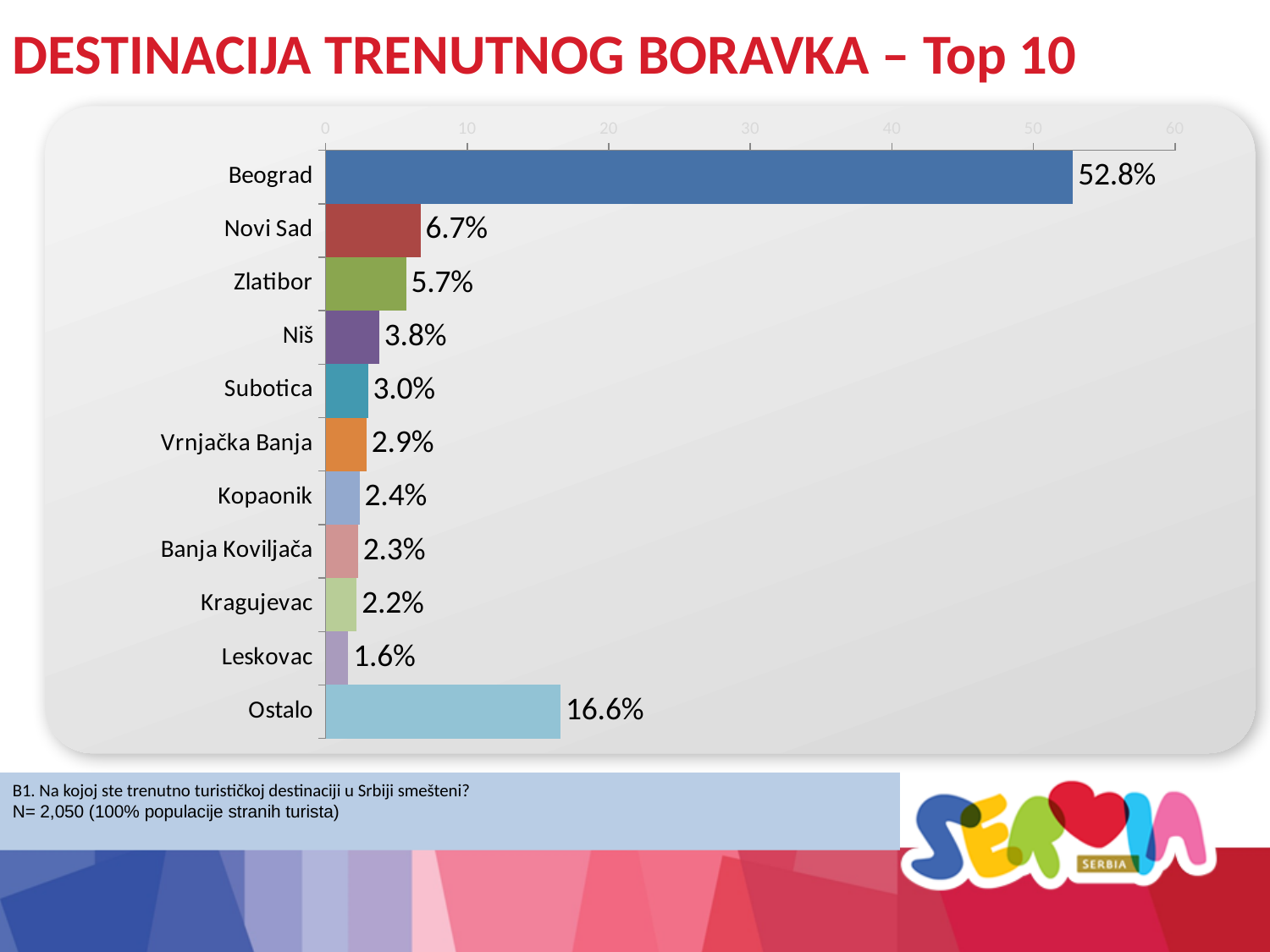
What is the difference between the values for Kopaonik and Kragujevac? 0.2% How many categories are shown in the chart? 11 Which is larger, the value for Niš or the value for Subotica? Niš Which category has the lowest value? Leskovac What kind of chart is shown on the slide? Bar chart What is the difference between the values for Beograd and Novi Sad? 46.1% What is the value for Beograd? 52.8% What is the value for Zlatibor? 5.7% What is the value for Ostalo? 16.6% Which category has the highest value? Beograd What is the title of the slide? DESTINACIJA TRENUTNOG BORAVKA – Top 10 Is the value for Beograd greater or less than 50? greater